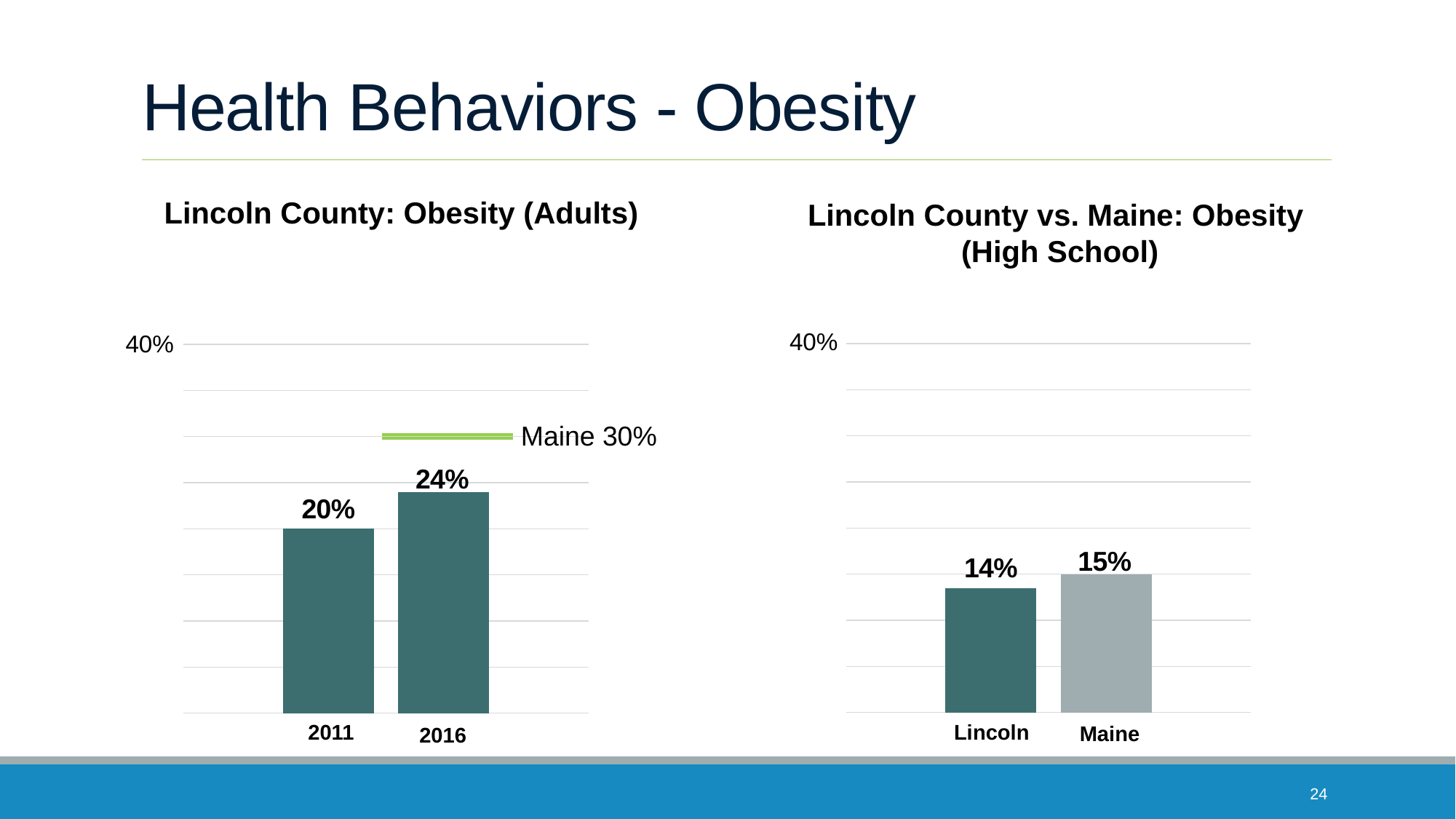
In the 'Lincoln County: Obesity (Adults)' chart, is the value for 2016 greater or less than 40%? less In the 'Lincoln County vs. Maine: Obesity (High School)' chart, which category has the higher value, Lincoln or Maine? Maine In the 'Lincoln County vs. Maine: Obesity (High School)' chart, what is the difference between the Maine and Lincoln values? 1% In the 'Lincoln County: Obesity (Adults)' chart, what is the difference between the 2016 and 2011 values? 4% What kind of chart is the 'Lincoln County vs. Maine: Obesity (High School)' chart? bar chart In the 'Lincoln County: Obesity (Adults)' chart, how many bars are plotted? 2 In the 'Lincoln County vs. Maine: Obesity (High School)' chart, what is the value for Maine? 15% In the 'Lincoln County: Obesity (Adults)' chart, what Maine value is marked by the green reference line? 30% In the 'Lincoln County: Obesity (Adults)' chart, do the values rise or fall from 2011 to 2016? rise In the 'Lincoln County: Obesity (Adults)' chart, what is the value for 2016? 24% In the 'Lincoln County vs. Maine: Obesity (High School)' chart, what is the value for Lincoln? 14% In the 'Lincoln County: Obesity (Adults)' chart, what is the value for 2011? 20%